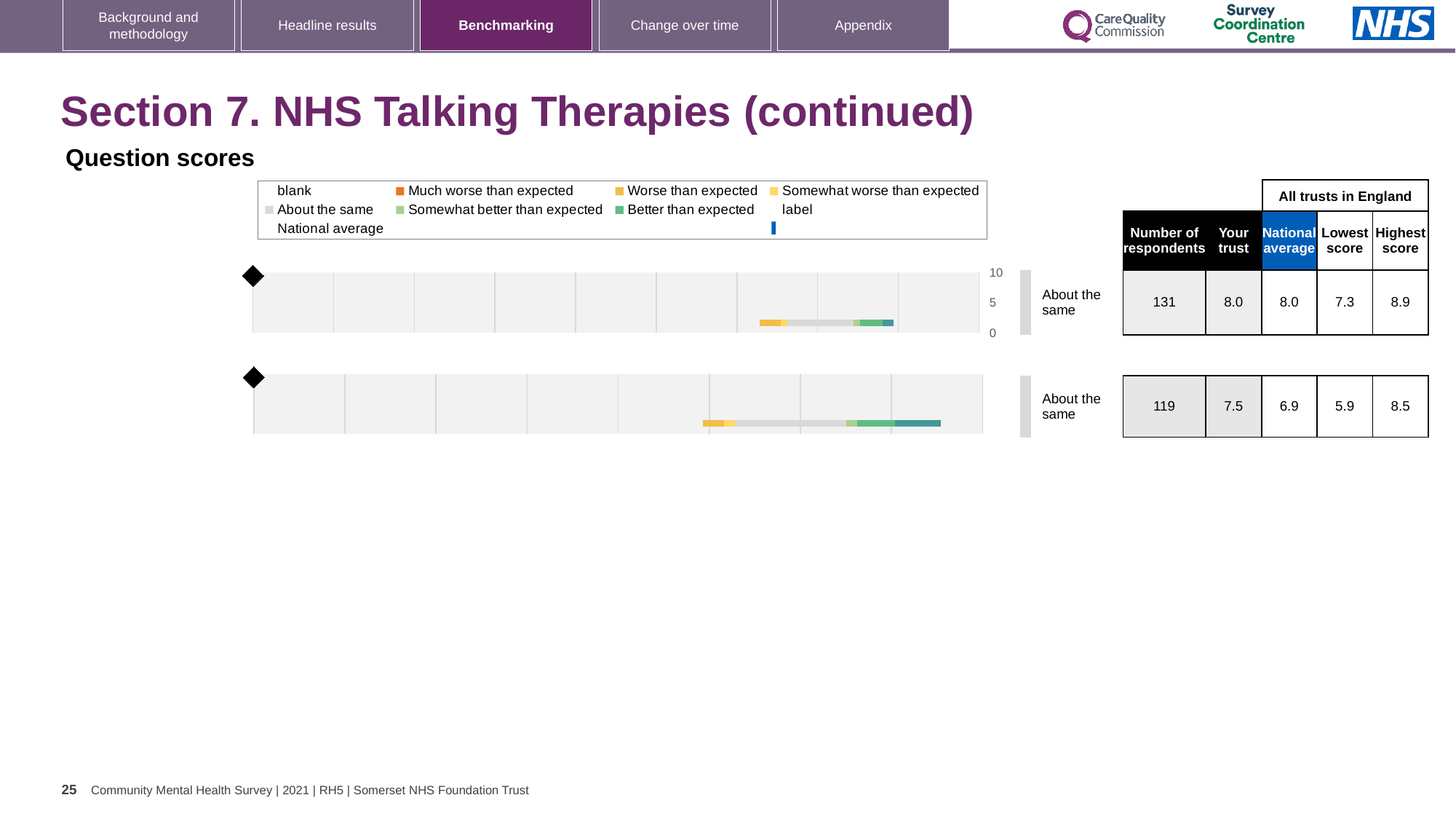
What kind of chart is used on the slide to show the question scores? Bar chart For the top chart row, what is the 'Your trust' score? 8.0 For the bottom chart row, what is the lowest score among all trusts in England? 5.9 For the top chart row, how many respondents are there? 131 For the top chart row, what is the highest score among all trusts in England? 8.9 For the bottom chart row, what is the difference between the 'Your trust' score and the national average? 0.6 What benchmark category label is shown next to both chart rows? About the same In the chart legend, which entry is shown with the orange colour? Much worse than expected For the top chart row, what is the difference between the highest score and the lowest score? 1.6 For the bottom chart row, which is larger: the 'Your trust' score or the national average? Your trust How many question score rows (charts) are shown on the slide? 2 For the bottom chart row, what is the national average score? 6.9